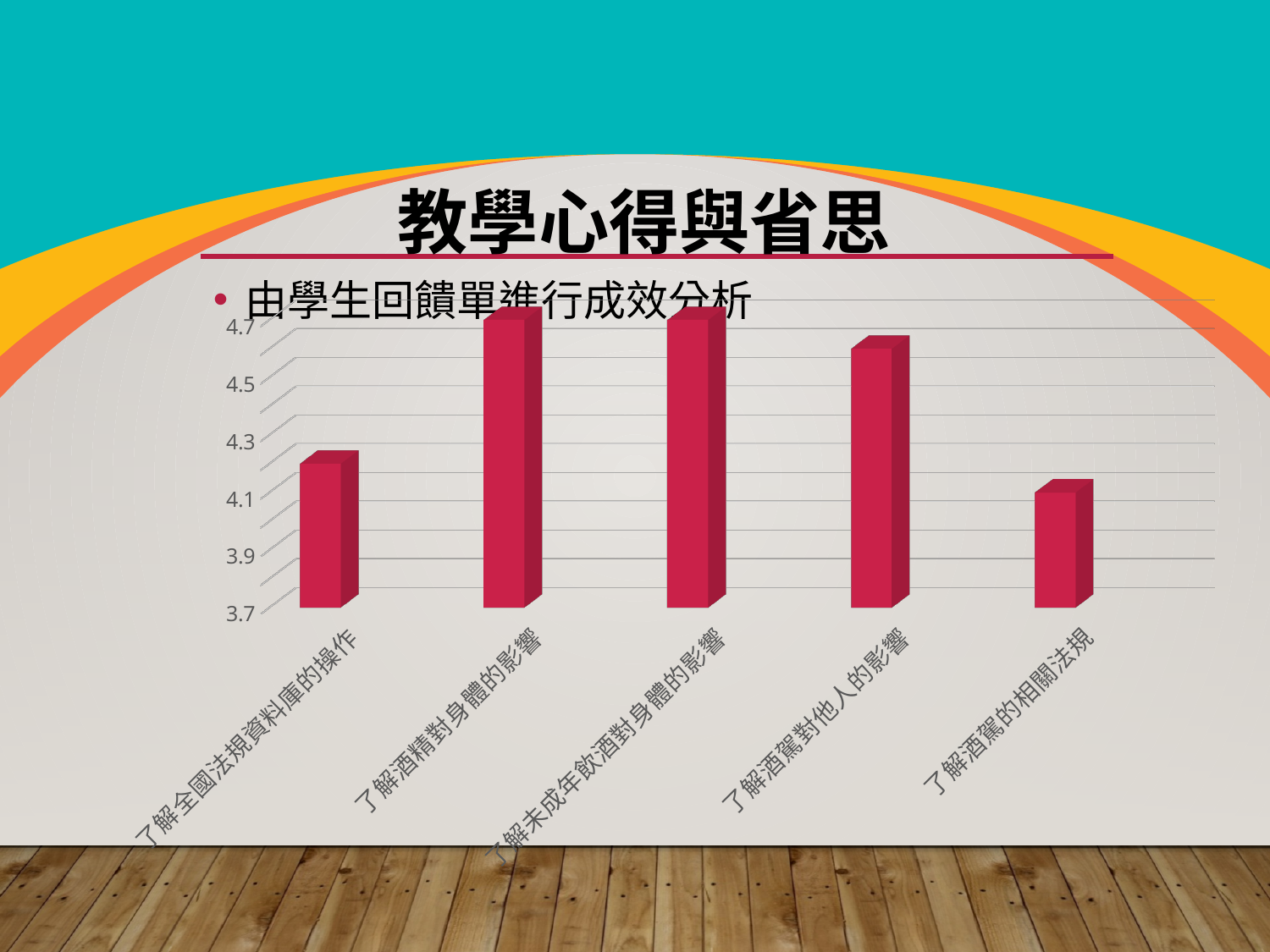
Is the value for 了解酒精對身體的影響 greater or less than 4.5? greater Is the value for 了解酒駕對他人的影響 greater or less than 4.5? greater What colour are the bars in the chart? red What kind of chart is shown on the slide? bar chart Which is larger, the value for 了解酒精對身體的影響 or the value for 了解酒駕的相關法規? 了解酒精對身體的影響 Which is larger, the value for 了解酒駕對他人的影響 or the value for 了解全國法規資料庫的操作? 了解酒駕對他人的影響 How many categories are plotted in the chart? 5 What is the lowest value shown on the chart's vertical axis? 3.7 Is the value for 了解全國法規資料庫的操作 greater or less than 4.1? greater Which category has the lowest value in the chart? 了解酒駕的相關法規